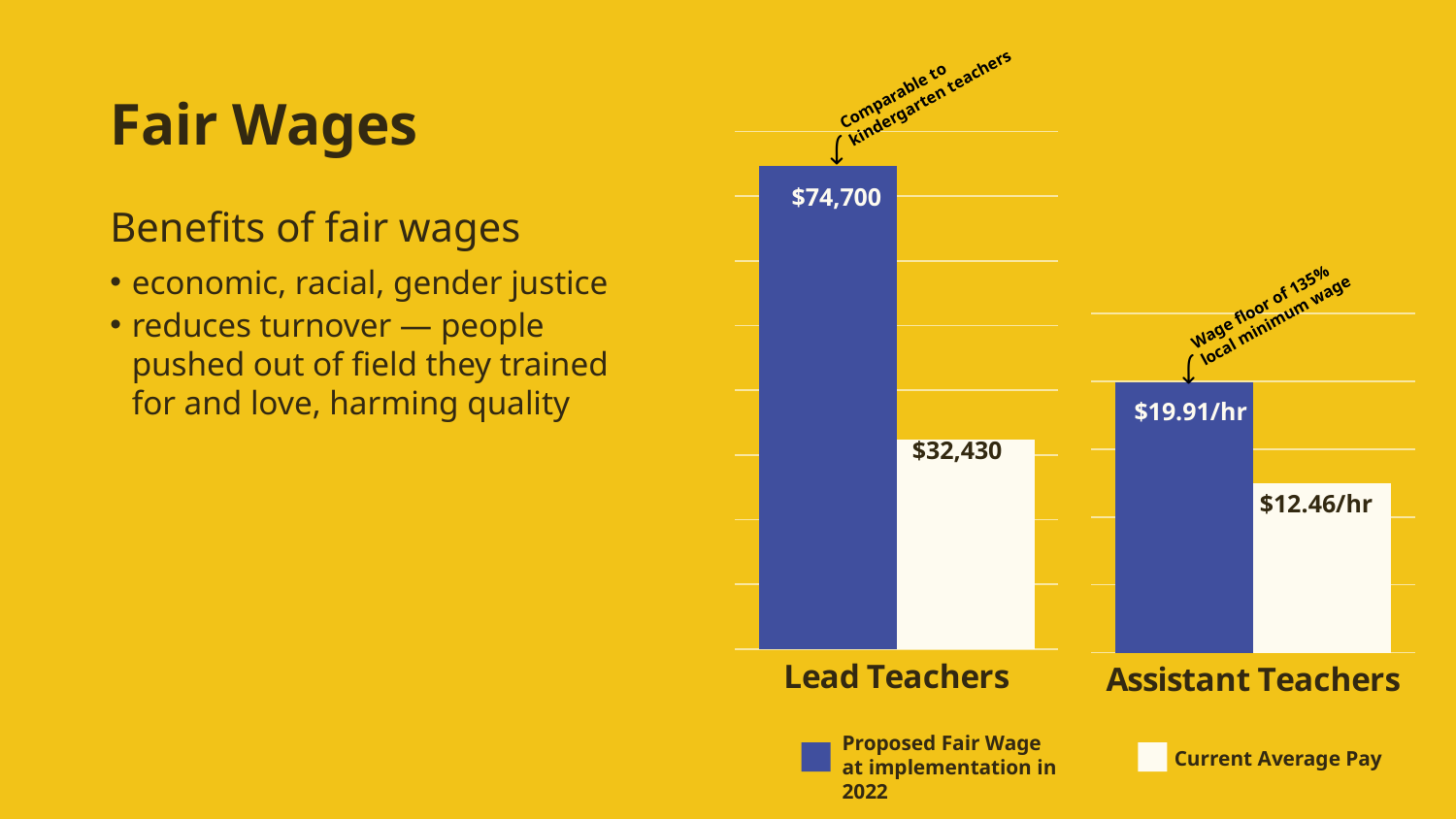
What is the difference between the proposed fair wage and the current average pay for Lead Teachers? $42,270 What is the proposed fair wage for Lead Teachers? $74,700 What is the proposed fair wage for Assistant Teachers? $19.91/hr For Assistant Teachers, which is larger: the current average pay or the proposed fair wage? Proposed fair wage What is the current average pay for Assistant Teachers? $12.46/hr For Lead Teachers, which is larger: the proposed fair wage or the current average pay? Proposed fair wage How many teacher categories are shown on the chart? 2 What kind of chart is shown on the slide? Bar chart What is the current average pay for Lead Teachers? $32,430 What is the difference between the proposed fair wage and the current average pay for Assistant Teachers? $7.45/hr How many series does the chart legend list? 2 Which series is shown in blue in the chart legend? Proposed Fair Wage at implementation in 2022